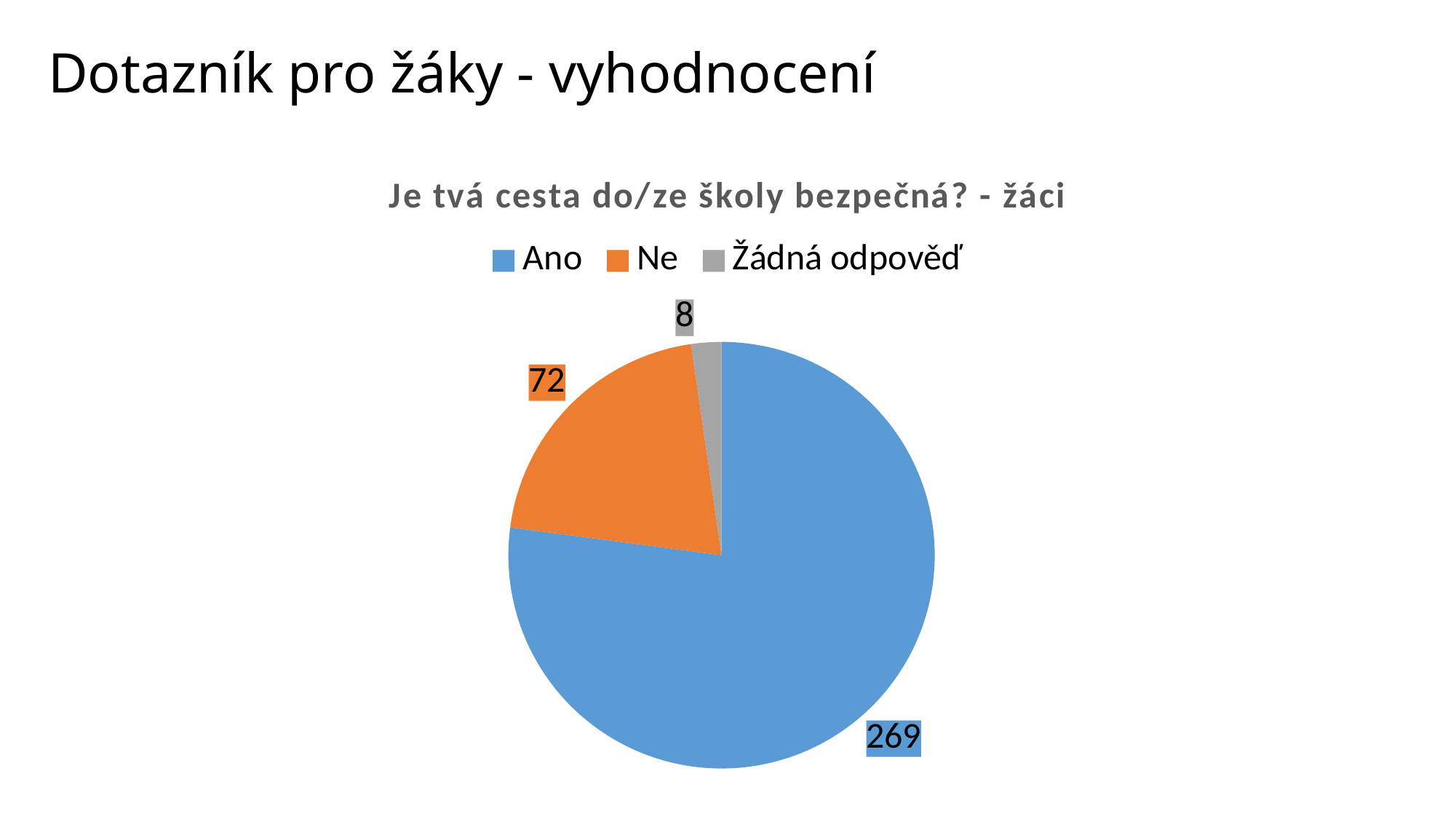
How many slices does the pie chart have? 3 Which is larger, the value for Ne or the value for Žádná odpověď? Ne Which category has the largest slice? Ano What is the title of the chart? Je tvá cesta do/ze školy bezpečná? - žáci How many entries does the chart legend list? 3 What is the value for Ano? 269 What is the total of all three slices? 349 What is the value for Ne? 72 What kind of chart is shown on the slide? pie chart What is the difference between the values for Ano and Ne? 197 Which category has the smallest slice? Žádná odpověď What is the value for Žádná odpověď? 8